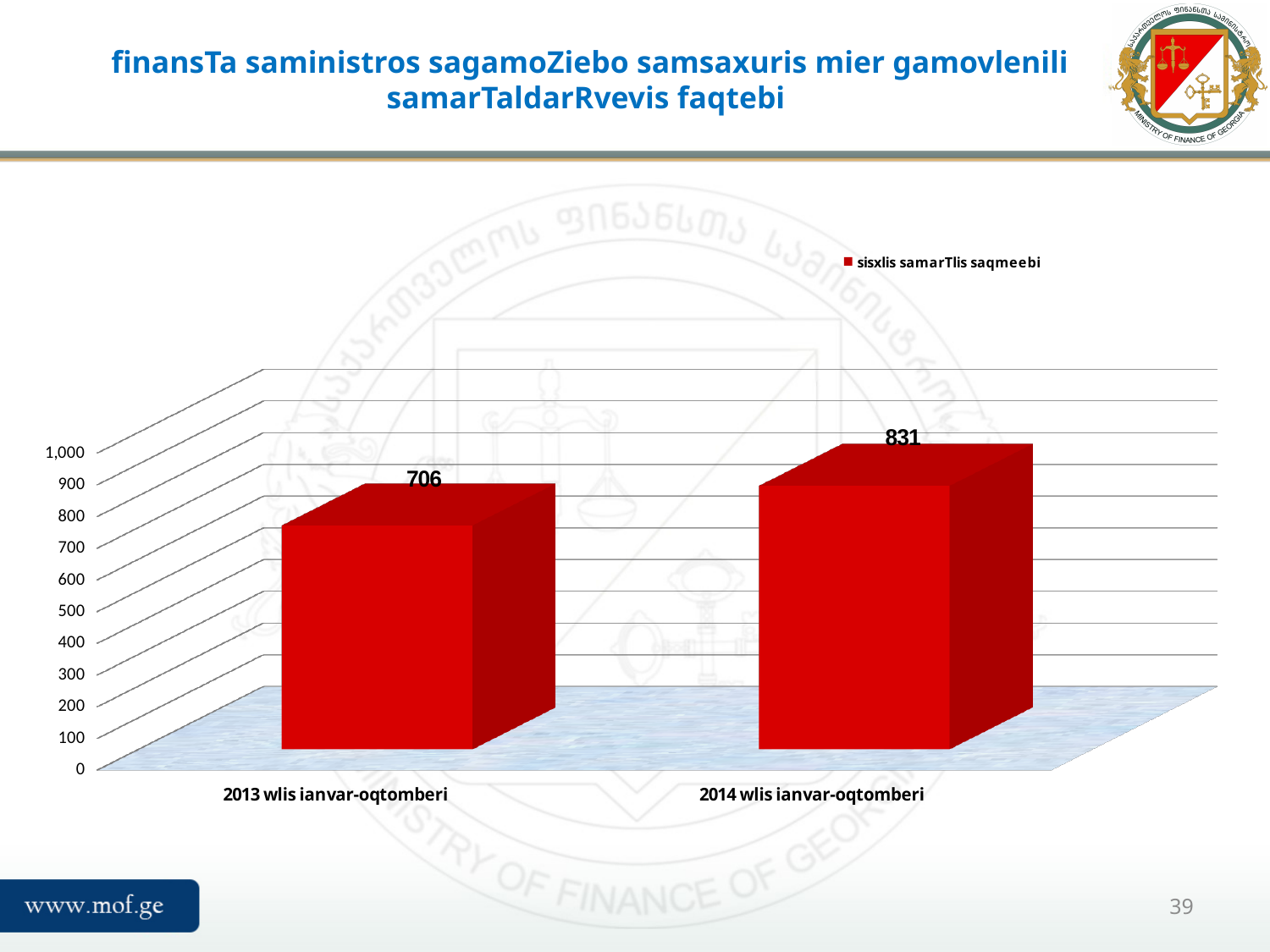
What is the value for 2014 wlis ianvar-oqtomberi? 831 Which is larger, the value for 2013 wlis ianvar-oqtomberi or 2014 wlis ianvar-oqtomberi? 2014 wlis ianvar-oqtomberi What kind of chart is shown on the slide? bar chart Is the value for 2013 wlis ianvar-oqtomberi greater or less than 800? less Is the value for 2014 wlis ianvar-oqtomberi greater or less than 800? greater Which category has the lowest value? 2013 wlis ianvar-oqtomberi What is the value for 2013 wlis ianvar-oqtomberi? 706 What is the difference between the values for 2014 wlis ianvar-oqtomberi and 2013 wlis ianvar-oqtomberi? 125 What is the name of the series shown in the legend? sisxlis samarTlis saqmeebi How many series does the legend list? 1 How many categories are shown on the x axis? 2 Which category has the highest value? 2014 wlis ianvar-oqtomberi